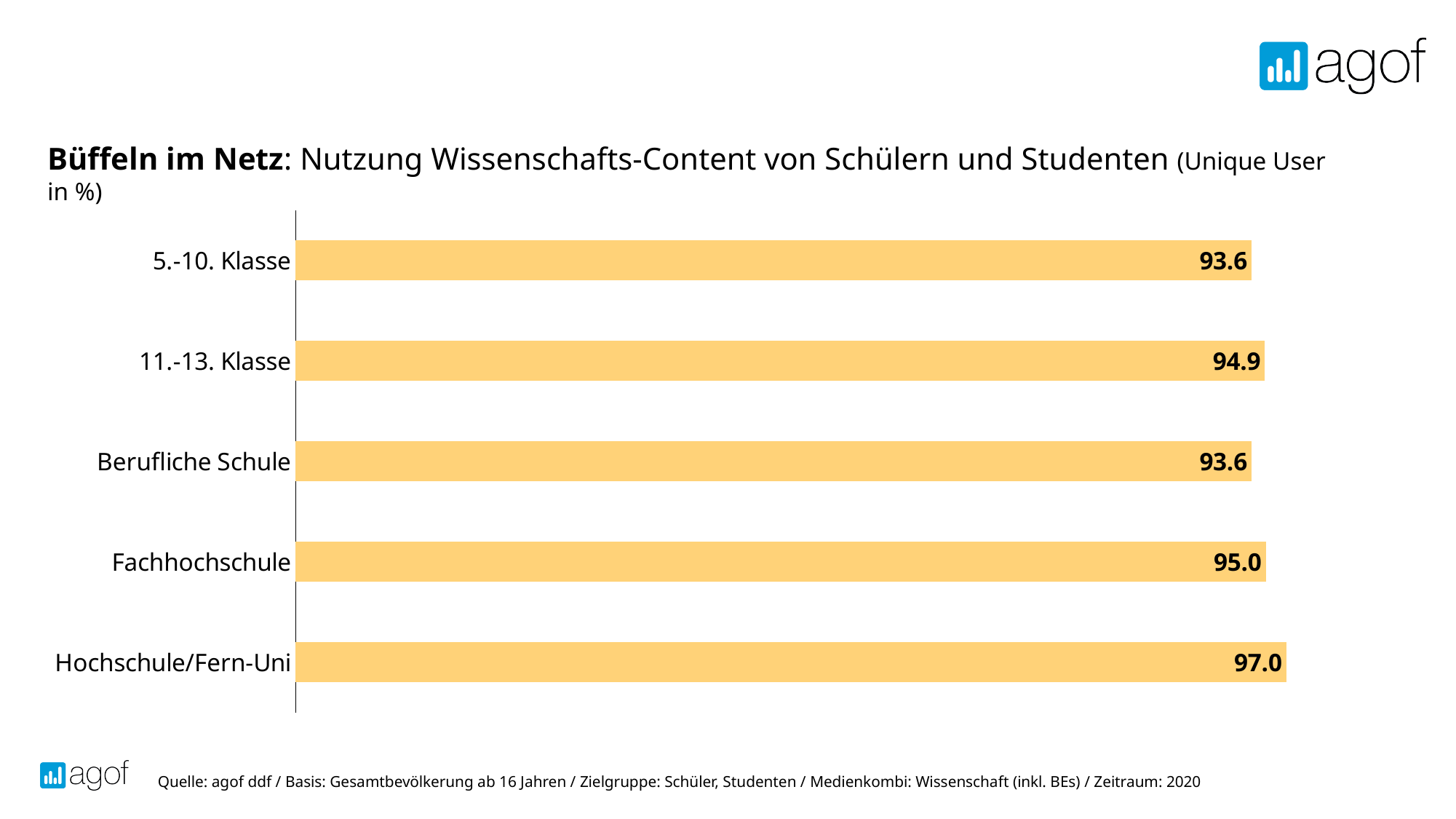
What is the value for Hochschule/Fern-Uni? 97.0 What is the value for Berufliche Schule? 93.6 What is the difference between the values for Hochschule/Fern-Uni and 5.-10. Klasse? 3.4 What is the value for 11.-13. Klasse? 94.9 What kind of chart is shown on the slide? Bar chart How many categories are shown in the chart? 5 Which category has the highest value? Hochschule/Fern-Uni What is the lowest value shown in the chart? 93.6 In what unit are the values in the chart given, according to the title? Unique User in % Which has a larger value, Hochschule/Fern-Uni or 11.-13. Klasse? Hochschule/Fern-Uni What is the value for Fachhochschule? 95.0 What is the difference between the values for Hochschule/Fern-Uni and Fachhochschule? 2.0